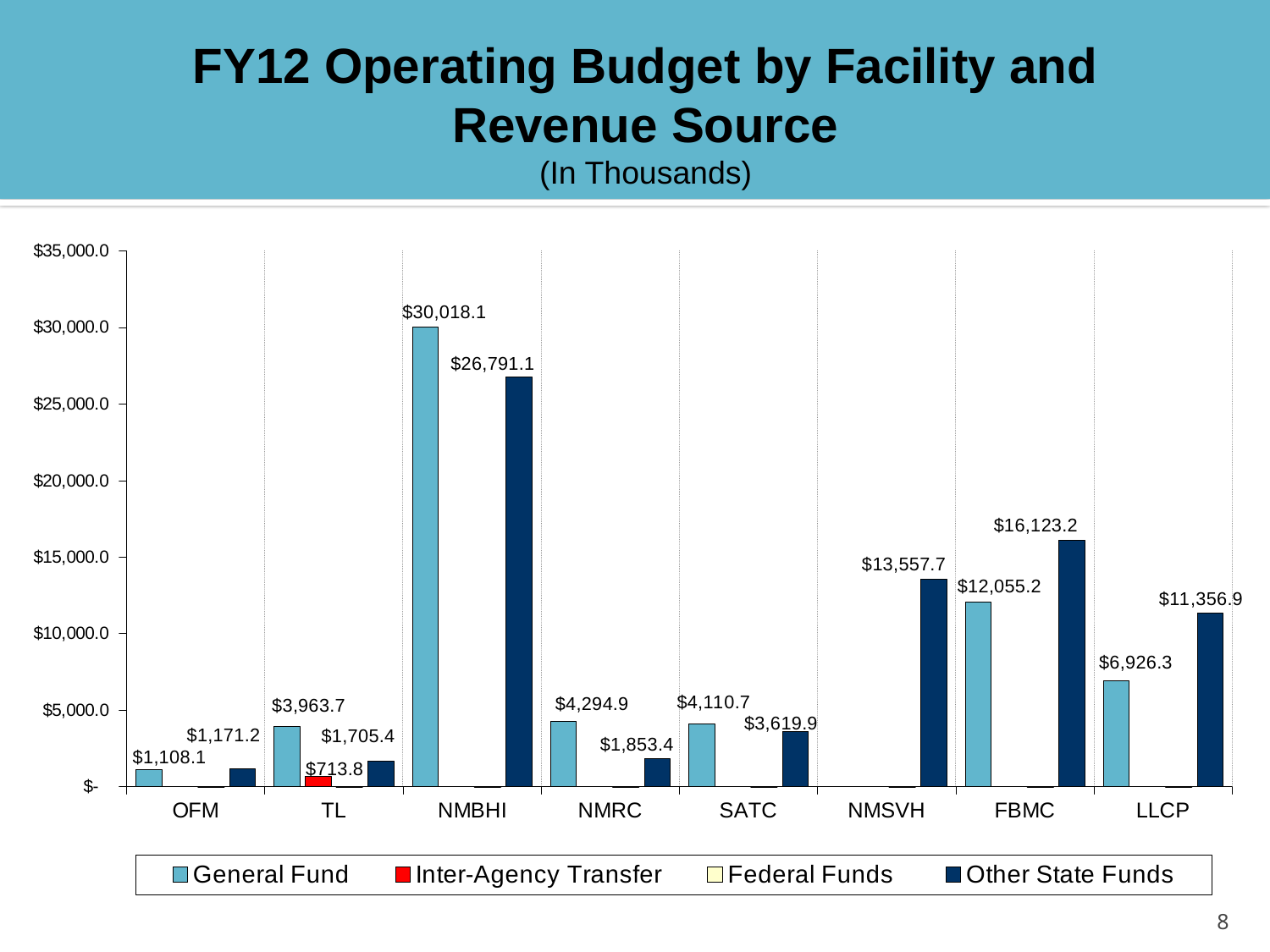
What is the difference between the Other State Funds and General Fund values for FBMC? $4,068.0 What is the difference between the General Fund and Other State Funds values for NMBHI? $3,227.0 Which facility has the highest General Fund value? NMBHI What kind of chart is shown on the slide? bar chart How many series does the legend list? 4 For FBMC, which is larger: General Fund or Other State Funds? Other State Funds How many facilities are shown on the x axis? 8 What is the General Fund value for NMBHI? $30,018.1 What is the Inter-Agency Transfer value for TL? $713.8 Is the General Fund value for LLCP greater or less than $5,000.0? greater What is the Other State Funds value for FBMC? $16,123.2 Which facility has the highest Other State Funds value? NMBHI